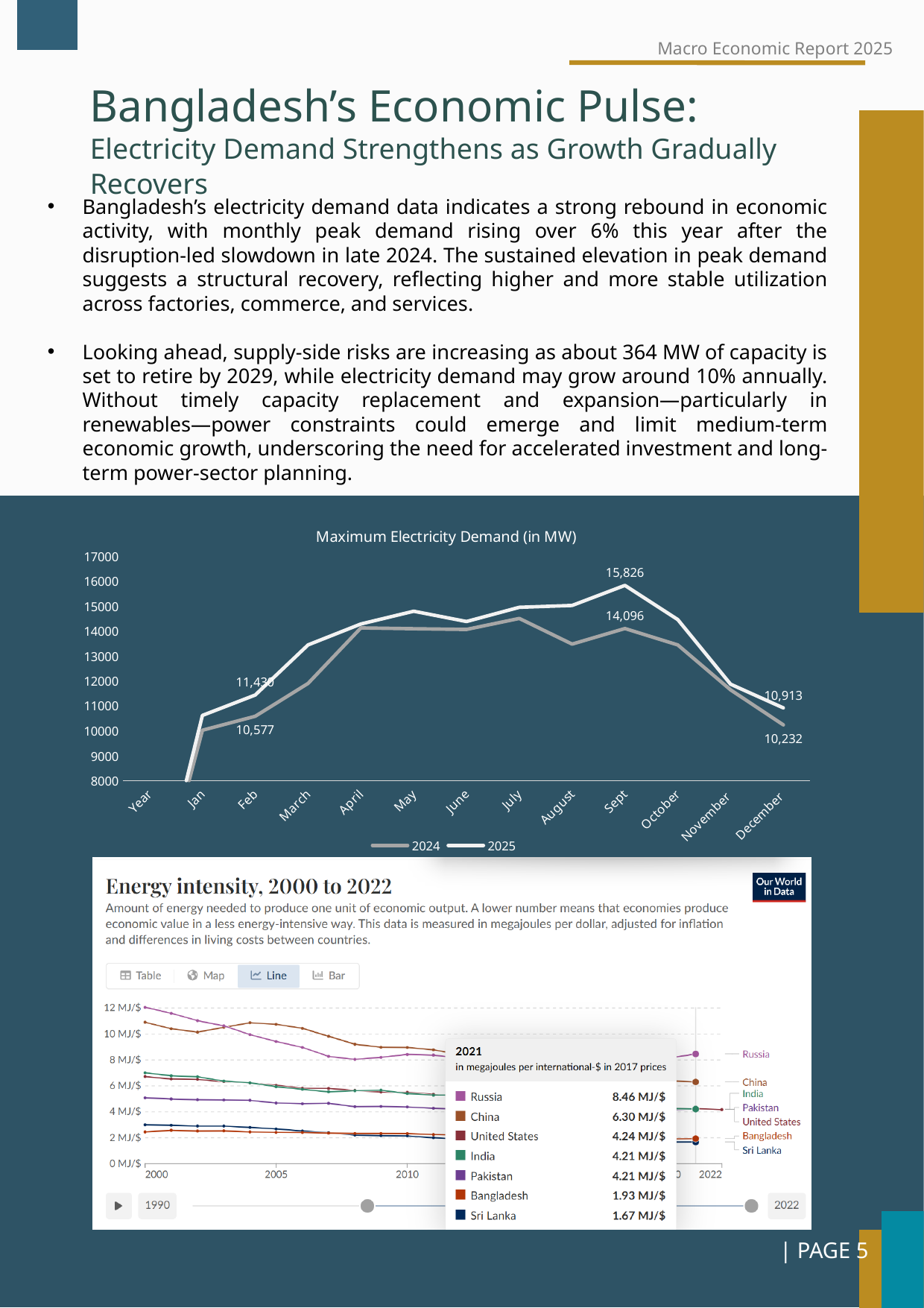
On the Maximum Electricity Demand chart, what is the 2025 value for Sept? 15,826 On the Maximum Electricity Demand chart, what is the 2024 value for Sept? 14,096 On the Energy intensity chart, which country has the lowest 2021 value in the tooltip? Sri Lanka On the Maximum Electricity Demand chart, is the 2024 value for August greater or less than 14000? less On the Maximum Electricity Demand chart, what is the difference between the 2025 and 2024 values for Sept? 1,730 On the Energy intensity chart, what is the 2021 value shown for Russia? 8.46 MJ/$ On the Maximum Electricity Demand chart, what is the 2024 value for December? 10,232 On the Maximum Electricity Demand chart, what kind of chart is used? line chart On the Maximum Electricity Demand chart, how many series does the legend list? 2 On the Maximum Electricity Demand chart, in which month does the 2025 series reach its highest value? Sept On the Energy intensity chart, what is the difference between the 2021 values for China and Bangladesh? 4.37 MJ/$ On the Maximum Electricity Demand chart, which is larger for 2024: the Feb value or the December value? Feb